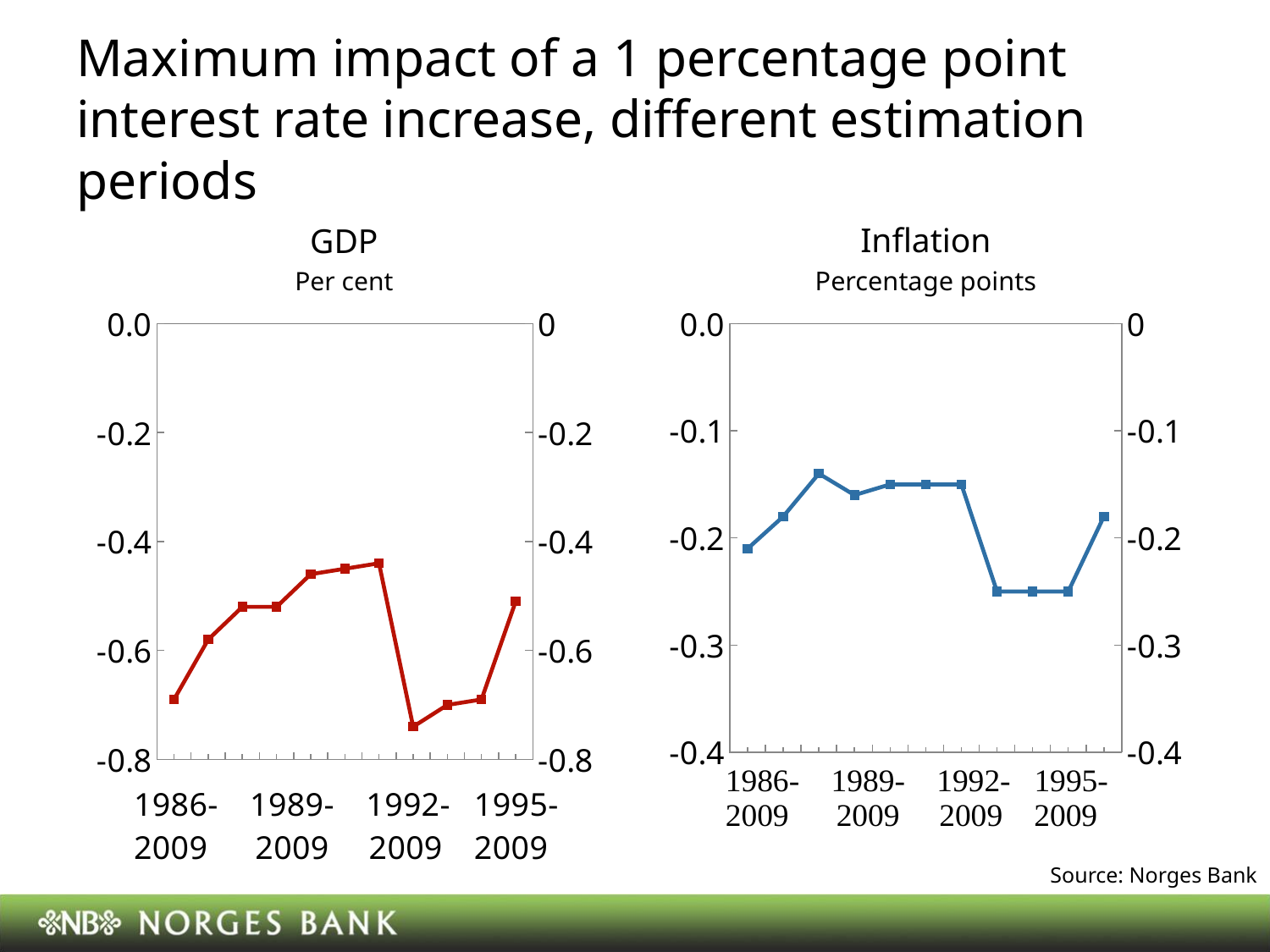
In the GDP chart, is the value for 1992-2009 greater or less than -0.6? greater What unit is shown under the title of the Inflation chart? Percentage points How many data points are plotted in the Inflation chart? 11 In the GDP chart, do the values rise or fall from 1986-2009 to 1992-2009? rise In the Inflation chart, is the value for 1995-2009 greater or less than -0.2? less In the GDP chart, which of the labelled estimation periods has the highest value? 1992-2009 In the GDP chart, is the value for 1986-2009 greater or less than -0.6? less In the GDP chart, which is larger, the value for 1986-2009 or the value for 1992-2009? 1992-2009 In the Inflation chart, which of the labelled estimation periods has the lowest value? 1995-2009 What kind of chart is the GDP chart? line chart